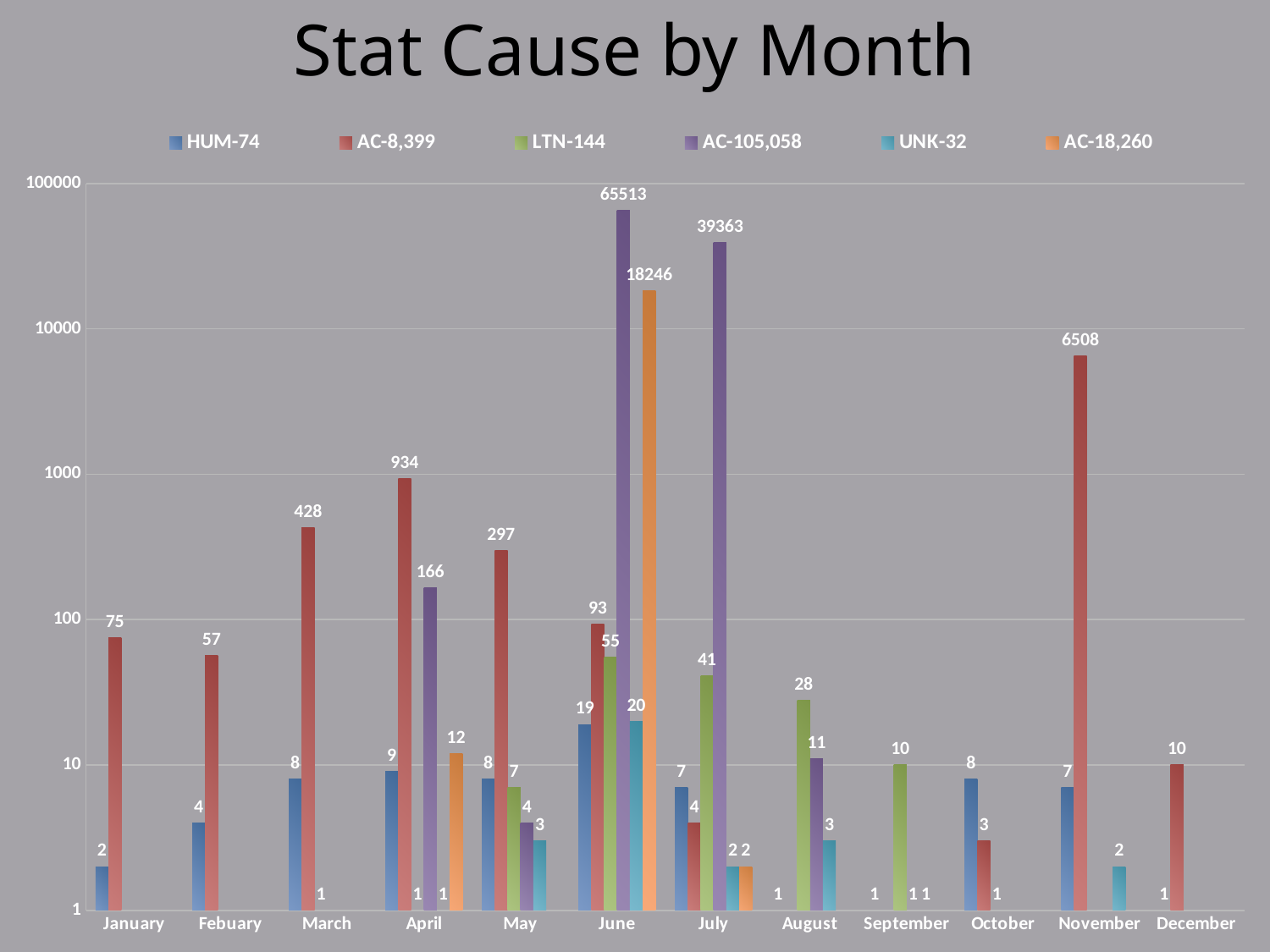
What kind of chart is shown on the slide? bar chart In which month is the LTN-144 value highest? June Which is larger, the AC-8,399 value for March or for April? April What is the value for HUM-74 in June? 19 What is the value for AC-8,399 in November? 6508 What is the value for AC-18,260 in June? 18246 What is the value for AC-105,058 in June? 65513 How many series does the legend list? 6 In which month is the AC-8,399 value highest? November What is the difference between the AC-105,058 values for June and July? 26150 How many months are shown on the x axis? 12 What is the value for LTN-144 in July? 41